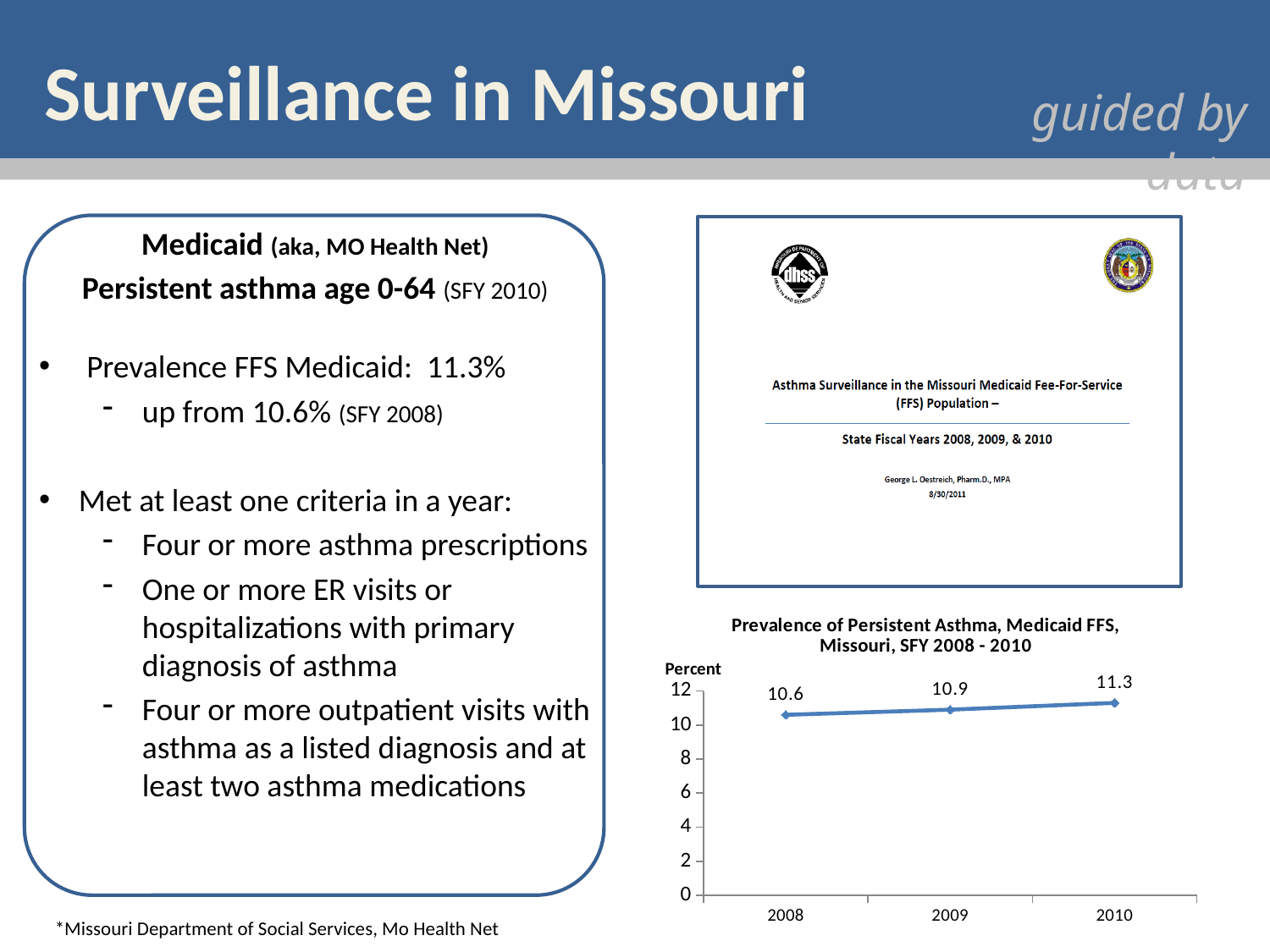
What is the prevalence value for 2008 in the chart? 10.6 What is the difference between the 2010 and 2008 prevalence values? 0.7 What is the prevalence value for 2010 in the chart? 11.3 Which is larger, the prevalence for 2009 or for 2010? 2010 Do the prevalence values rise or fall from 2008 to 2010? rise What is the prevalence value for 2009 in the chart? 10.9 What kind of chart is shown on the slide? line chart What is the title of the chart? Prevalence of Persistent Asthma, Medicaid FFS, Missouri, SFY 2008 - 2010 How many years are plotted in the chart? 3 Which year has the highest prevalence in the chart? 2010 Which year has the lowest prevalence in the chart? 2008 Is the value for 2008 greater or less than 10? greater